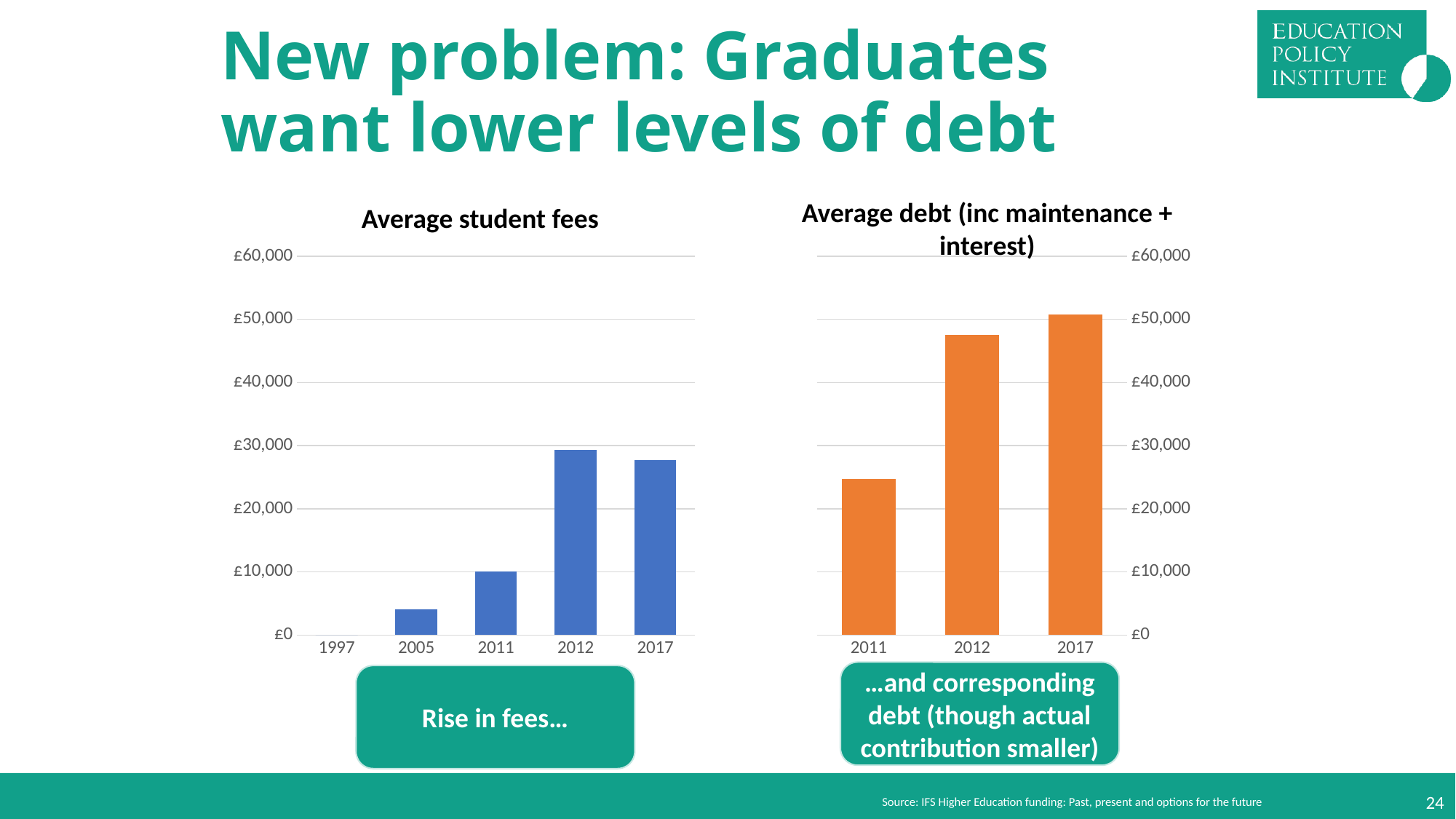
In the 'Average student fees' chart, which is larger, the value for 2011 or the value for 2012? 2012 In the 'Average student fees' chart, is the value for 2005 greater or less than £10,000? less What kind of chart is the 'Average student fees' chart? bar chart How many years are shown on the x axis of the 'Average debt (inc maintenance + interest)' chart? 3 In the 'Average debt (inc maintenance + interest)' chart, which year has the lowest value? 2011 In the 'Average student fees' chart, is the value for 2017 greater or less than £20,000? greater How many years are shown on the x axis of the 'Average student fees' chart? 5 In the 'Average student fees' chart, which year has the highest value? 2012 What colour are the bars in the 'Average debt (inc maintenance + interest)' chart? orange In the 'Average debt (inc maintenance + interest)' chart, is the value for 2011 greater or less than £30,000? less In the 'Average debt (inc maintenance + interest)' chart, which year has the highest value? 2017